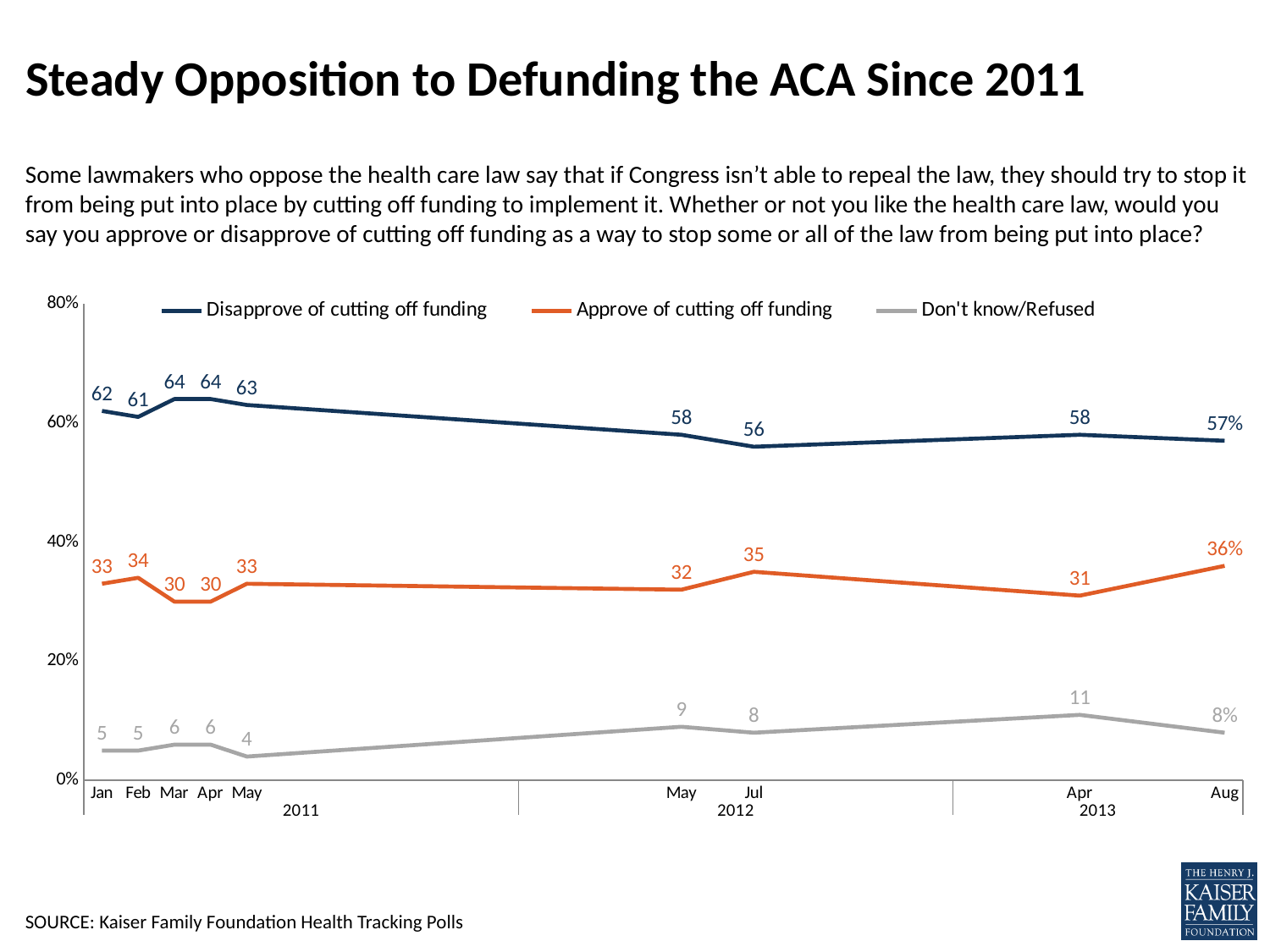
What was the value for 'Approve of cutting off funding' in Jul 2012? 35 How many series does the legend list? 3 What was the value for 'Disapprove of cutting off funding' in Aug 2013? 57% In which month(s) did 'Disapprove of cutting off funding' reach its highest value? Mar and Apr 2011 (64) Did 'Disapprove of cutting off funding' rise or fall from May 2011 to Jul 2012? fall Which was larger in May 2012: 'Disapprove of cutting off funding' or 'Approve of cutting off funding'? Disapprove of cutting off funding What type of chart is shown on the slide? line chart What was the lowest value recorded for 'Don't know/Refused'? 4 What is the difference between 'Disapprove of cutting off funding' and 'Approve of cutting off funding' in Aug 2013? 21% What colour is the line for 'Approve of cutting off funding'? orange How many data points are plotted for each series? 9 What was the value for 'Don't know/Refused' in Apr 2013? 11